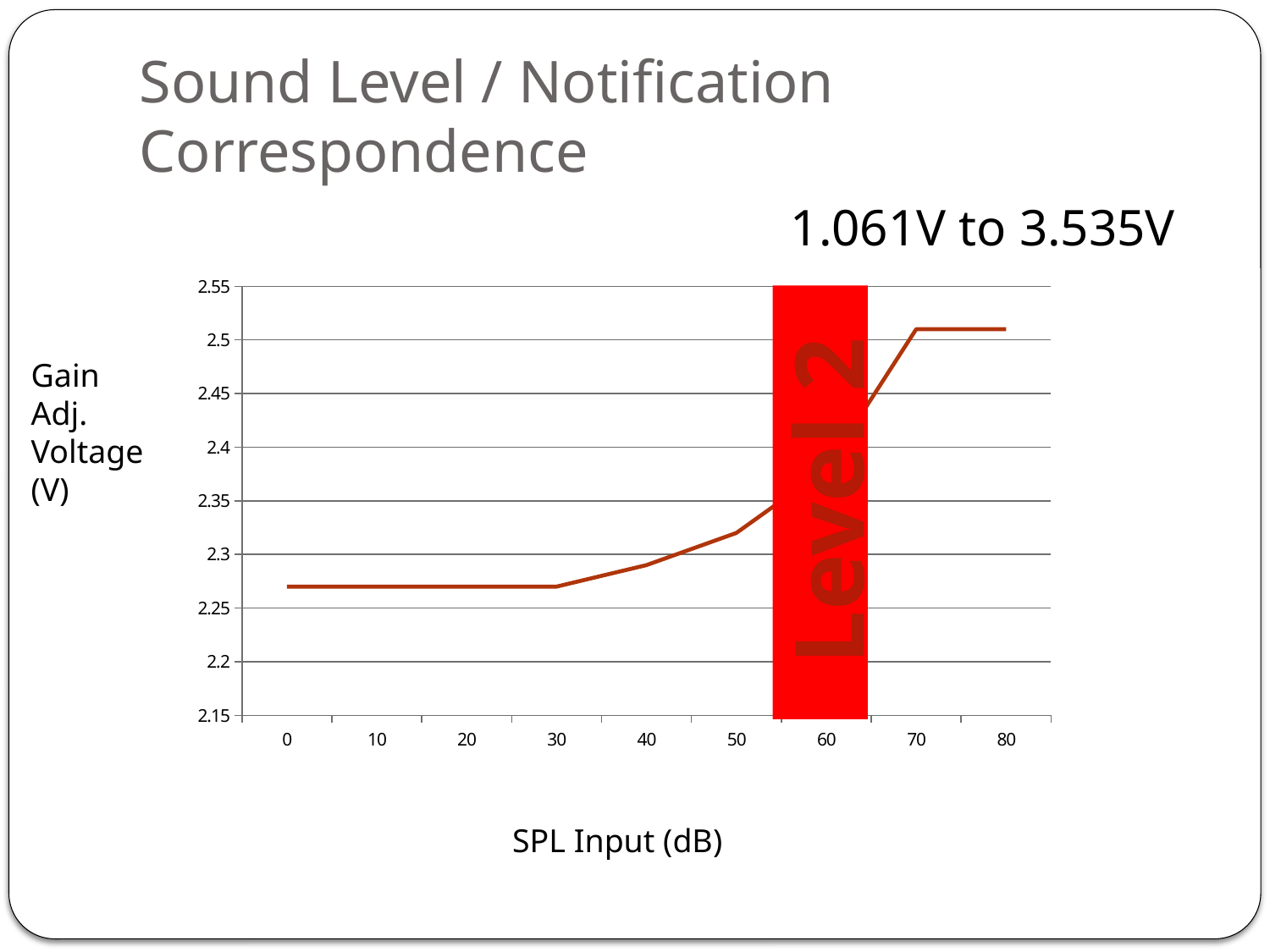
Is the Gain Adj. Voltage at 40 dB SPL Input greater or less than 2.35? less What is the title of the x axis of the chart? SPL Input (dB) Does the Gain Adj. Voltage generally rise or fall as SPL Input increases from 0 to 80 dB? rise Which has a higher Gain Adj. Voltage: 30 dB or 70 dB SPL Input? 70 dB Which has a lower Gain Adj. Voltage: 10 dB or 60 dB SPL Input? 10 dB What kind of chart is shown on the slide? line chart How many SPL Input tick values are shown along the x axis? 9 Is the Gain Adj. Voltage at 0 dB SPL Input greater or less than 2.3? less What label is written inside the red shaded band on the chart? Level 2 Is the Gain Adj. Voltage at 70 dB SPL Input greater or less than 2.45? greater